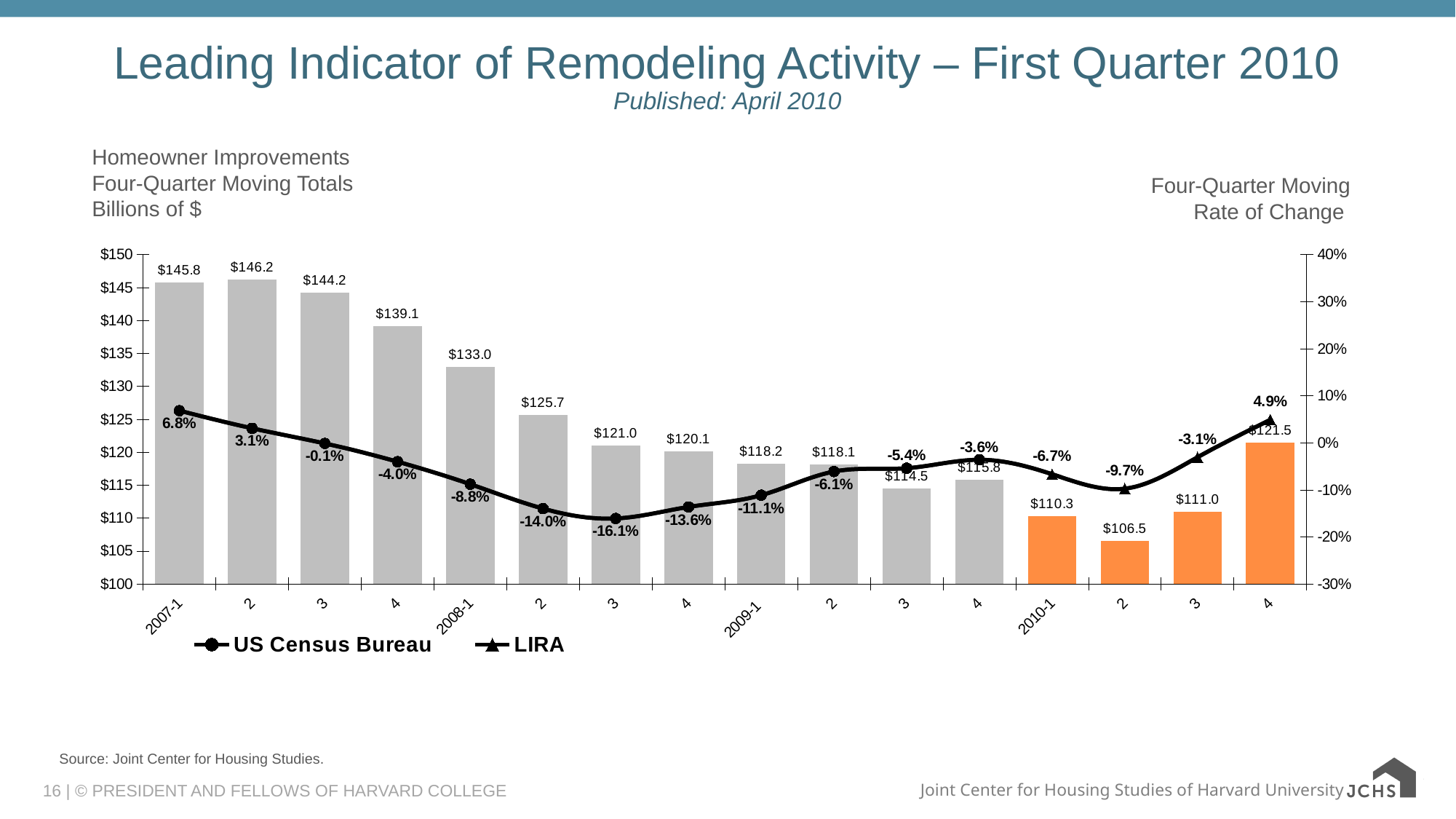
Which quarter has the highest four-quarter moving total (bar)? 2007-2 How many quarters (bars) are plotted on the chart? 16 Do the four-quarter moving totals rise or fall from 2007-1 to 2010-2? Fall How many series does the legend list? 2 Which quarter has the lowest four-quarter moving rate of change on the line? 2008-3 What is the rate of change shown for the last quarter, 2010-4? 4.9% What is the four-quarter moving total of homeowner improvements for 2007-1? $145.8 What kind of chart is shown on the slide? Combination bar and line chart What is the difference between the four-quarter moving totals for 2007-1 and 2010-4? $24.3 What is the four-quarter moving rate of change shown for 2008-3? -16.1% Which quarter has the lowest four-quarter moving total (bar)? 2010-2 Which has the larger four-quarter moving total, 2009-3 or 2009-4? 2009-4